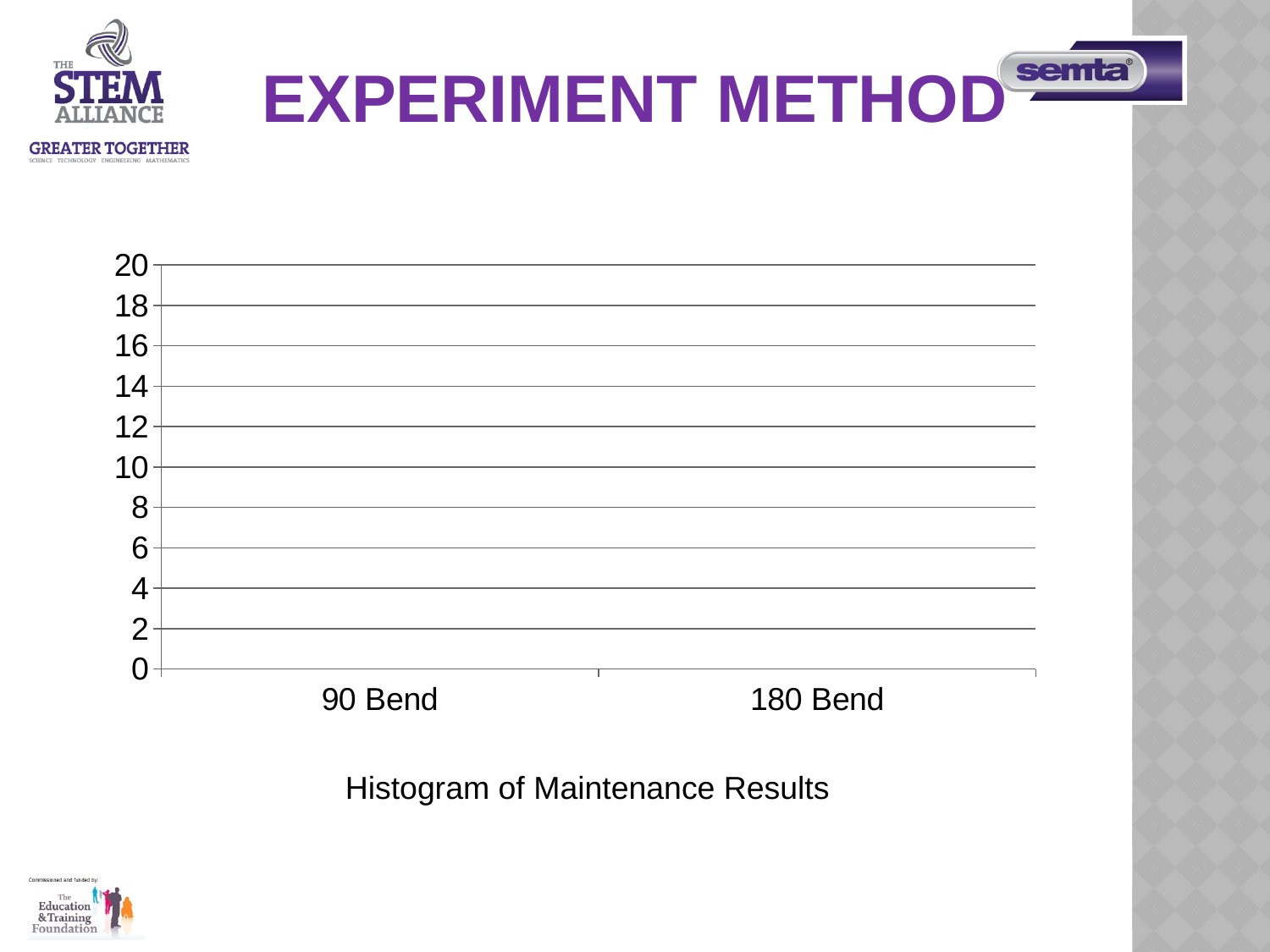
What are the two category labels on the x axis of the chart? 90 Bend and 180 Bend Are any bars plotted on the chart? No What is the caption shown below the chart? Histogram of Maintenance Results What is the highest value shown on the chart's y axis? 20 What is the interval between consecutive tick marks on the chart's y axis? 2 How many categories are labelled on the x axis of the chart? 2